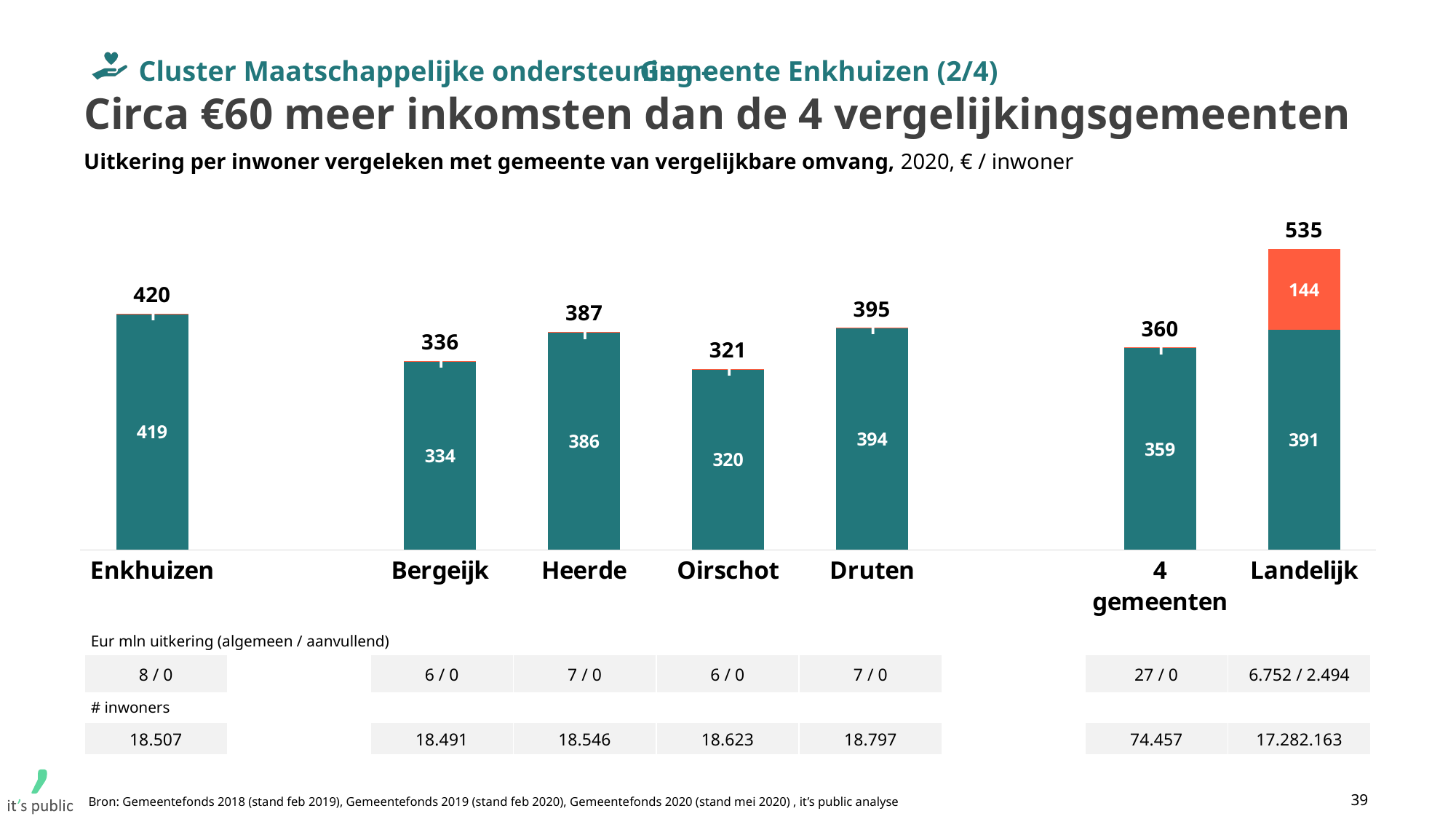
What is the difference between the total for Enkhuizen and the total for 4 gemeenten? 60 Which has a larger total value, Heerde or Druten? Druten What is the value of the teal segment in the Oirschot bar? 320 What is the total value shown above the bar for Enkhuizen? 420 What is the value of the orange (aanvullend) segment in the Landelijk bar? 144 Which category has the highest total value? Landelijk What kind of chart is shown on the slide? Stacked bar chart How many categories are shown on the x axis of the chart? 7 What is the number of inhabitants (# inwoners) listed for Enkhuizen below the chart? 18.507 Which category has the lowest total value? Oirschot What is the total value shown above the bar for Landelijk? 535 What is the total of the stacked bar for Landelijk, given its segments 391 and 144? 535